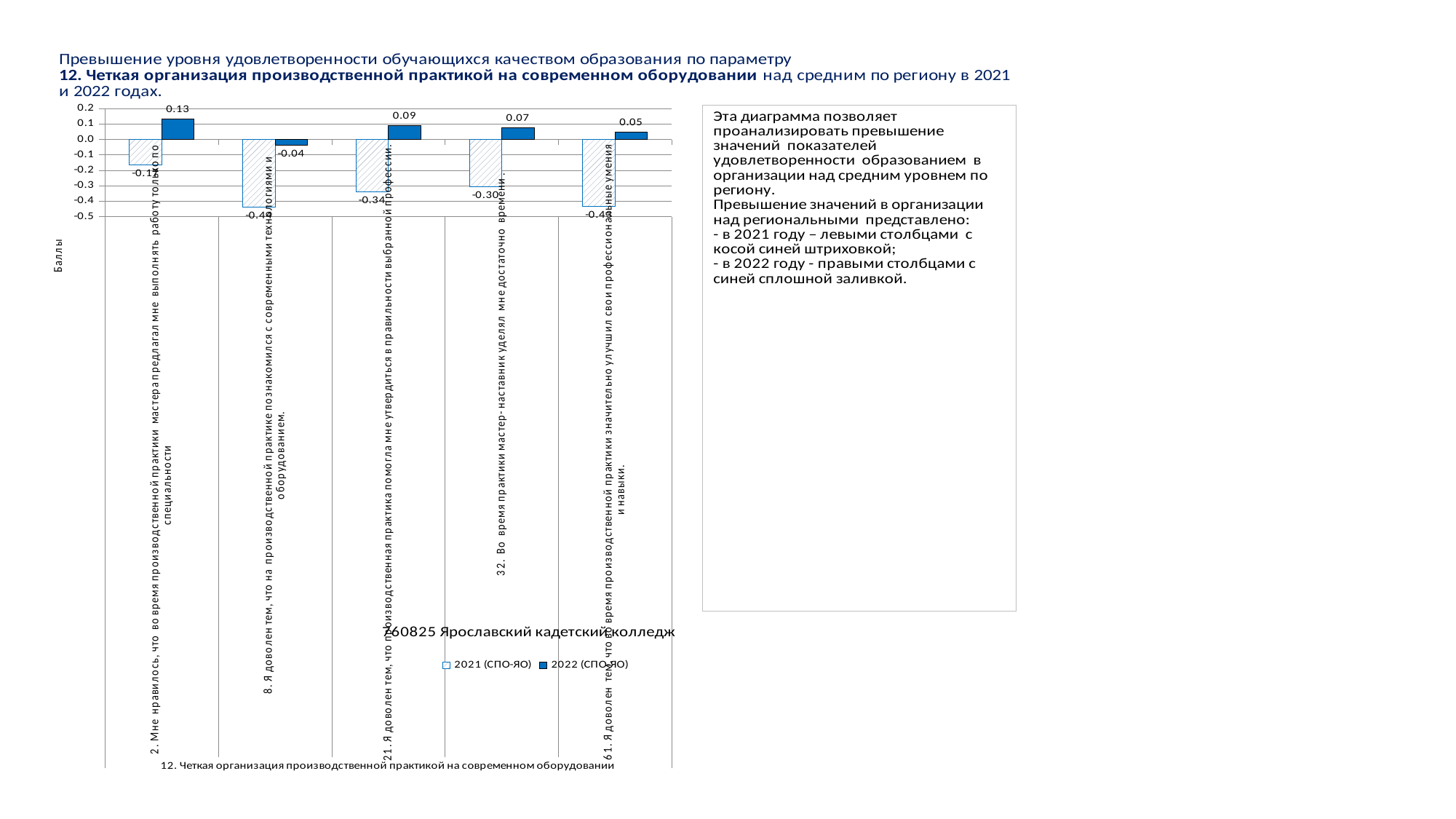
Which category has the lowest 2022 (СПО-ЯО) value? 8. Я доволен тем, что на производственной практике познакомился с современными технологиями и оборудованием What is the 2021 (СПО-ЯО) value for item 21 ("Я доволен тем, что производственная практика помогла мне утвердиться в правильности выбранной профессии")? -0.34 How many series does the legend list? 2 What is the difference between the 2022 and 2021 values for item 21 ("Я доволен тем, что производственная практика помогла мне утвердиться в правильности выбранной профессии")? 0.43 What is the 2021 (СПО-ЯО) value for item 32 ("Во время практики мастер-наставник уделял мне достаточно времени")? -0.30 Which category has the highest 2022 (СПО-ЯО) value? 2. Мне нравилось, что во время производственной практики мастер предлагал мне выполнять работу только по специальности What is the 2022 (СПО-ЯО) value for item 8 ("Я доволен тем, что на производственной практике познакомился с современными технологиями и оборудованием")? -0.04 What is the 2022 (СПО-ЯО) value for item 2 ("Мне нравилось, что во время производственной практики мастер предлагал мне выполнять работу только по специальности")? 0.13 Is the 2021 (СПО-ЯО) value for item 61 ("Я доволен тем, что во время производственной практики значительно улучшил свои профессиональные умения и навыки") greater or less than -0.4? less How many categories (survey items) are shown on the chart? 5 What kind of chart is shown on the slide? Bar chart Which is larger: the 2022 (СПО-ЯО) value for item 21 or for item 32? Item 21 (0.09)